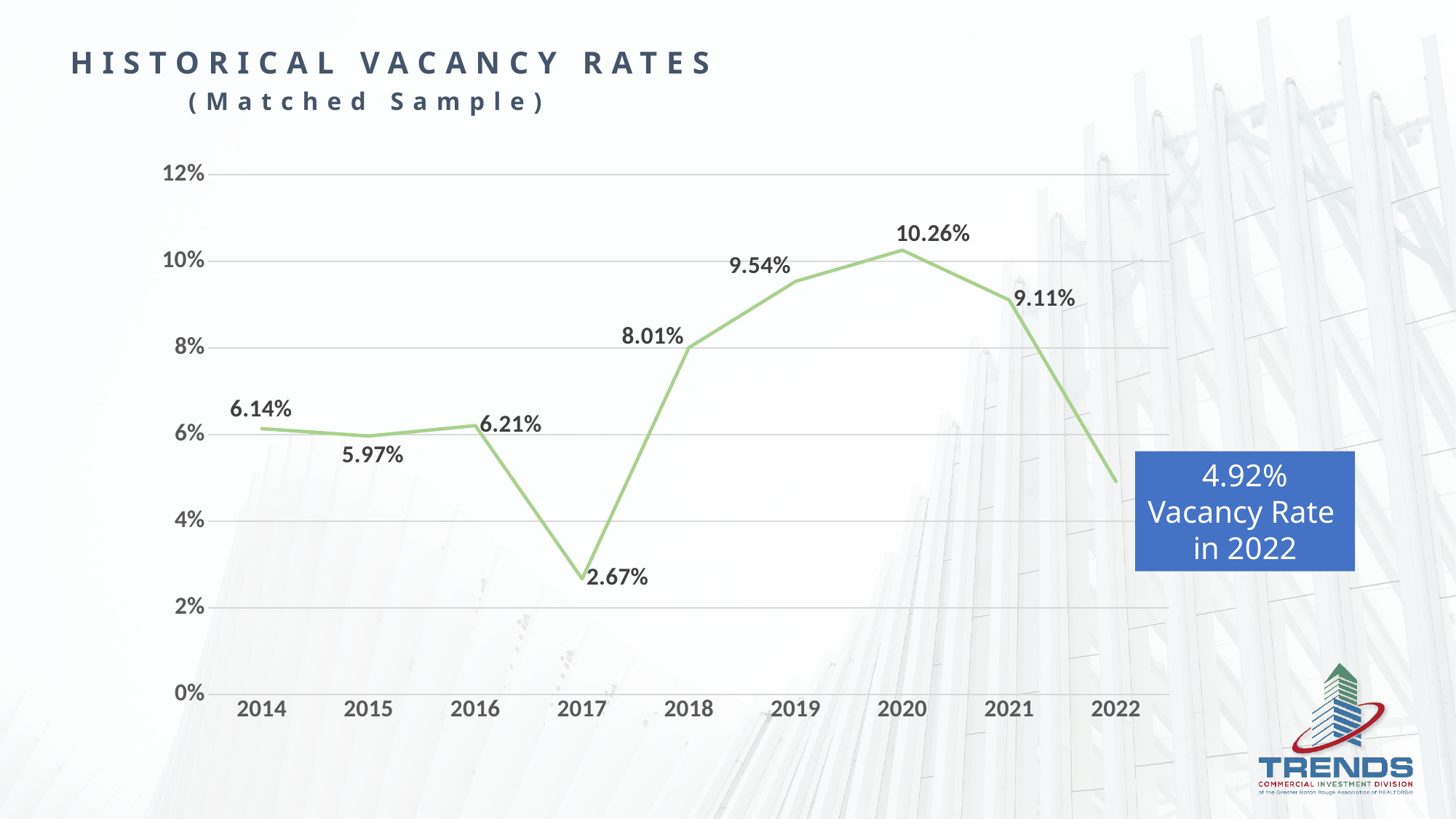
What was the vacancy rate in 2020? 10.26% Which year had a higher vacancy rate, 2018 or 2019? 2019 Did the vacancy rate rise or fall from 2020 to 2022? Fall How many years are shown on the x axis? 9 Which year had the highest vacancy rate? 2020 What is the difference between the vacancy rates in 2020 and 2021? 1.15% Is the vacancy rate for 2021 greater or less than 8%? greater What was the vacancy rate in 2022? 4.92% What kind of chart is shown on the slide? Line chart What was the vacancy rate in 2017? 2.67% Which year had the lowest vacancy rate? 2017 What is the title of the chart? Historical Vacancy Rates (Matched Sample)